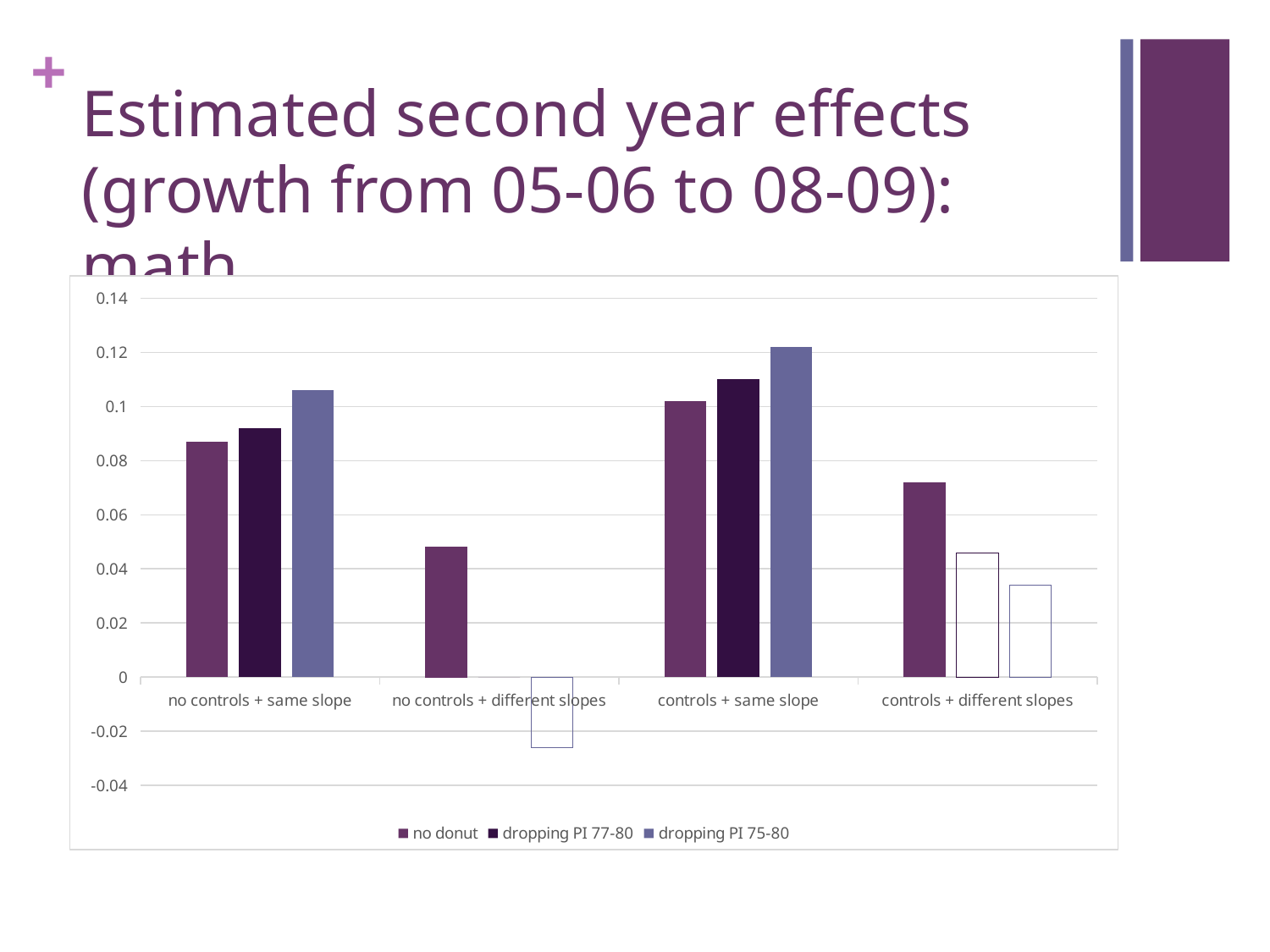
What kind of chart is shown on the slide? bar chart Which category has the highest value for the 'dropping PI 75-80' series? controls + same slope Is the 'dropping PI 75-80' value for 'controls + same slope' greater or less than 0.1? greater Is the 'no donut' value for 'no controls + same slope' greater or less than 0.08? greater How many series does the legend list? 3 Which category has a bar that falls below zero? no controls + different slopes Is the 'no donut' value for 'no controls + different slopes' greater or less than 0.06? less For 'controls + same slope', which is larger: the 'no donut' value or the 'dropping PI 75-80' value? dropping PI 75-80 Which category has the lowest value for the 'no donut' series? no controls + different slopes How many categories are shown on the x axis? 4 What are the three series named in the legend? no donut, dropping PI 77-80, dropping PI 75-80